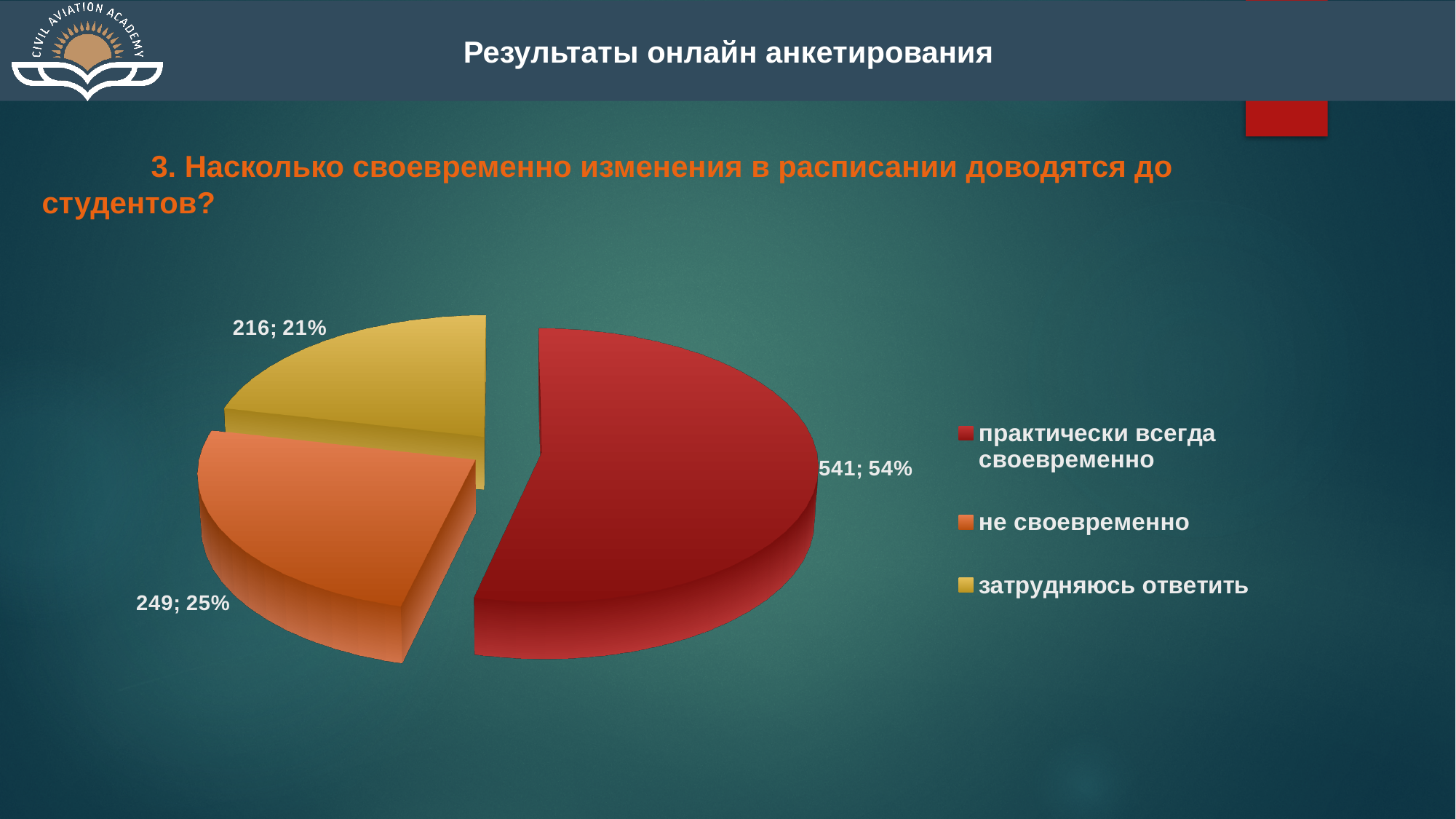
What kind of chart is shown on the slide? Pie chart Which category has the largest slice? практически всегда своевременно How many entries does the legend list? 3 What is the count for "затрудняюсь ответить"? 216 What share of the pie does "практически всегда своевременно" take? 54% What is the count for "не своевременно"? 249 How many slices does the pie chart have? 3 What is the difference between the counts for "практически всегда своевременно" and "не своевременно"? 292 What is the count for "практически всегда своевременно"? 541 Which colour represents "не своевременно" in the legend? Orange Which category has the smallest slice? затрудняюсь ответить What share of the pie does "затрудняюсь ответить" take? 21%